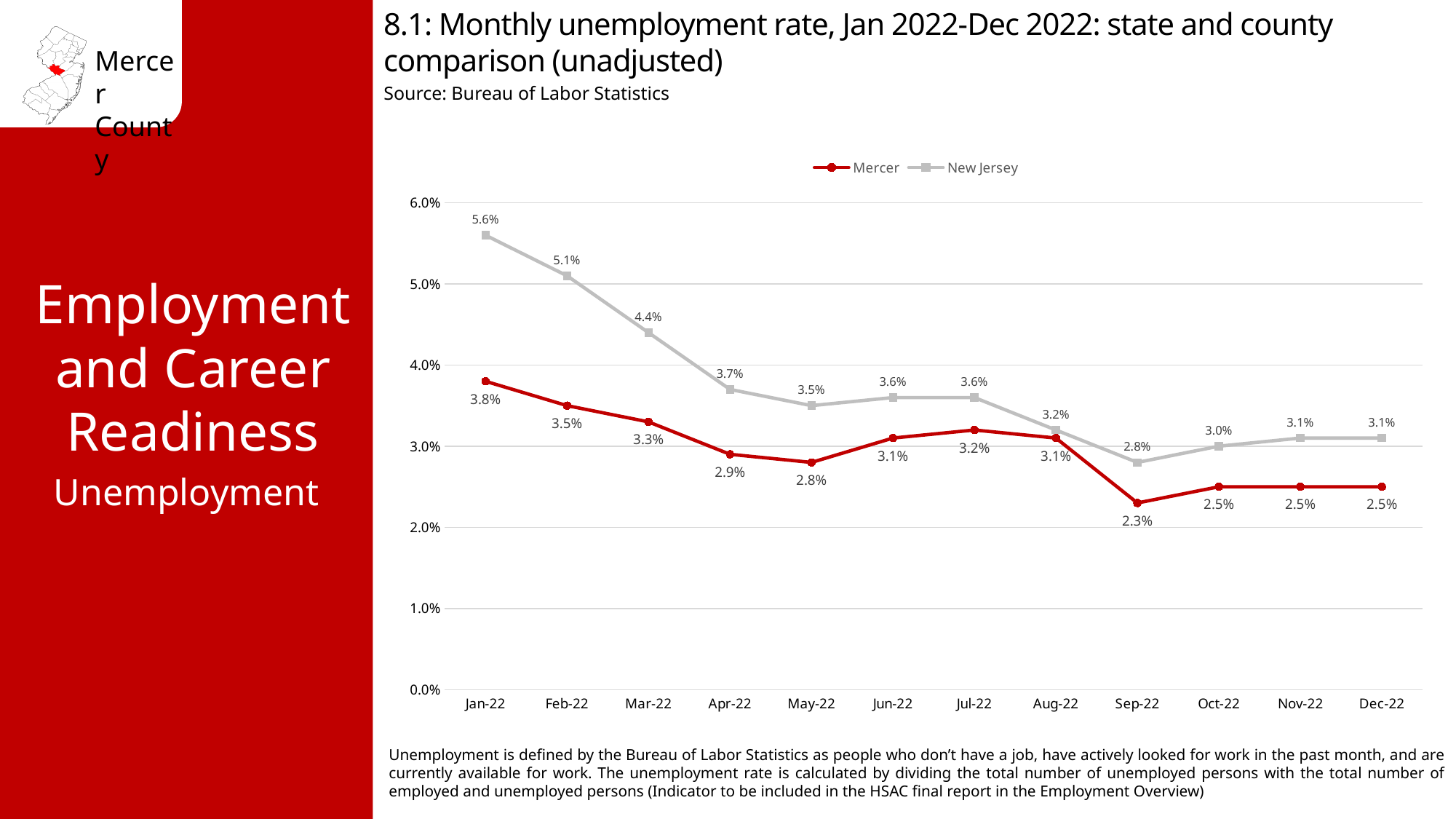
Is the New Jersey unemployment rate in Feb-22 greater or less than 5.0%? greater How many months are plotted on the x axis? 12 What was the Mercer unemployment rate in Jan-22? 3.8% Does the New Jersey unemployment rate generally rise or fall from Jan-22 to Sep-22? Fall What was the Mercer unemployment rate in Sep-22? 2.3% In which month was the Mercer unemployment rate lowest? Sep-22 What was the New Jersey unemployment rate in Mar-22? 4.4% Which series had the higher unemployment rate in Apr-22, Mercer or New Jersey? New Jersey How many series does the legend list? 2 What is the difference between the New Jersey and Mercer unemployment rates in Jan-22? 1.8% In which month was the New Jersey unemployment rate highest? Jan-22 What kind of chart is shown on the slide? Line chart